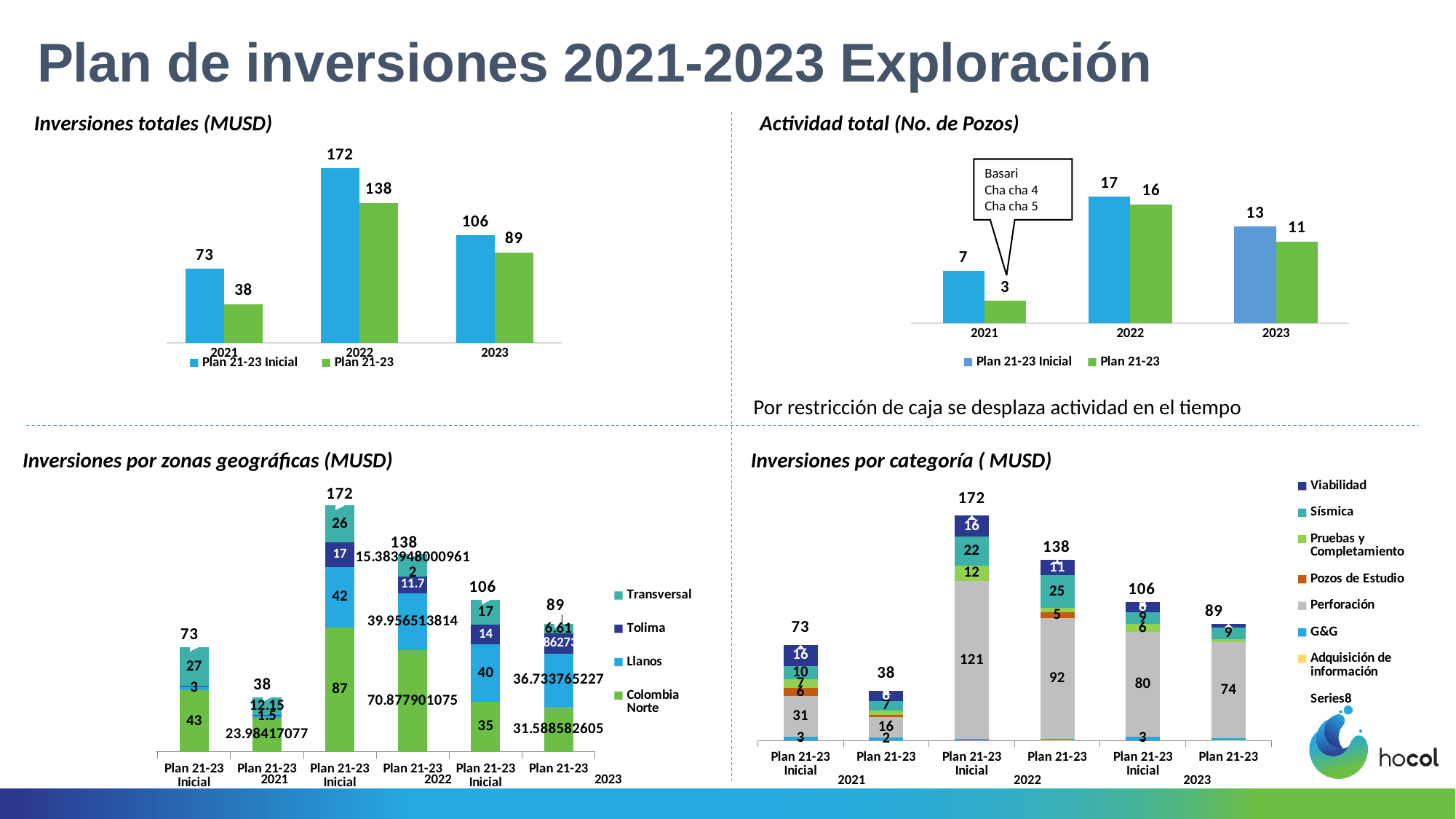
In the 'Actividad total (No. de Pozos)' chart, what is the value for Plan 21-23 in 2021? 3 In the 'Actividad total (No. de Pozos)' chart, how many years are shown on the x axis? 3 In the 'Inversiones por zonas geográficas (MUSD)' chart, what is the total of the Plan 21-23 Inicial 2023 stacked bar? 106 In the 'Actividad total (No. de Pozos)' chart, which year has the lowest Plan 21-23 value? 2021 In the 'Actividad total (No. de Pozos)' chart, what is the value for Plan 21-23 Inicial in 2022? 17 In the 'Inversiones por zonas geográficas (MUSD)' chart, what is the Colombia Norte value for Plan 21-23 Inicial 2022? 87 In the 'Inversiones totales (MUSD)' chart, what is the difference between Plan 21-23 Inicial and Plan 21-23 in 2023? 17 In the 'Inversiones totales (MUSD)' chart, what is the value for Plan 21-23 in 2021? 38 In the 'Inversiones por categoría ( MUSD)' chart, what is the Perforación value for Plan 21-23 Inicial 2022? 121 In the 'Inversiones totales (MUSD)' chart, which year has the highest Plan 21-23 Inicial value? 2022 In the 'Inversiones por categoría ( MUSD)' chart, how many entries does the legend list? 8 In the 'Inversiones totales (MUSD)' chart, what is the value for Plan 21-23 Inicial in 2022? 172